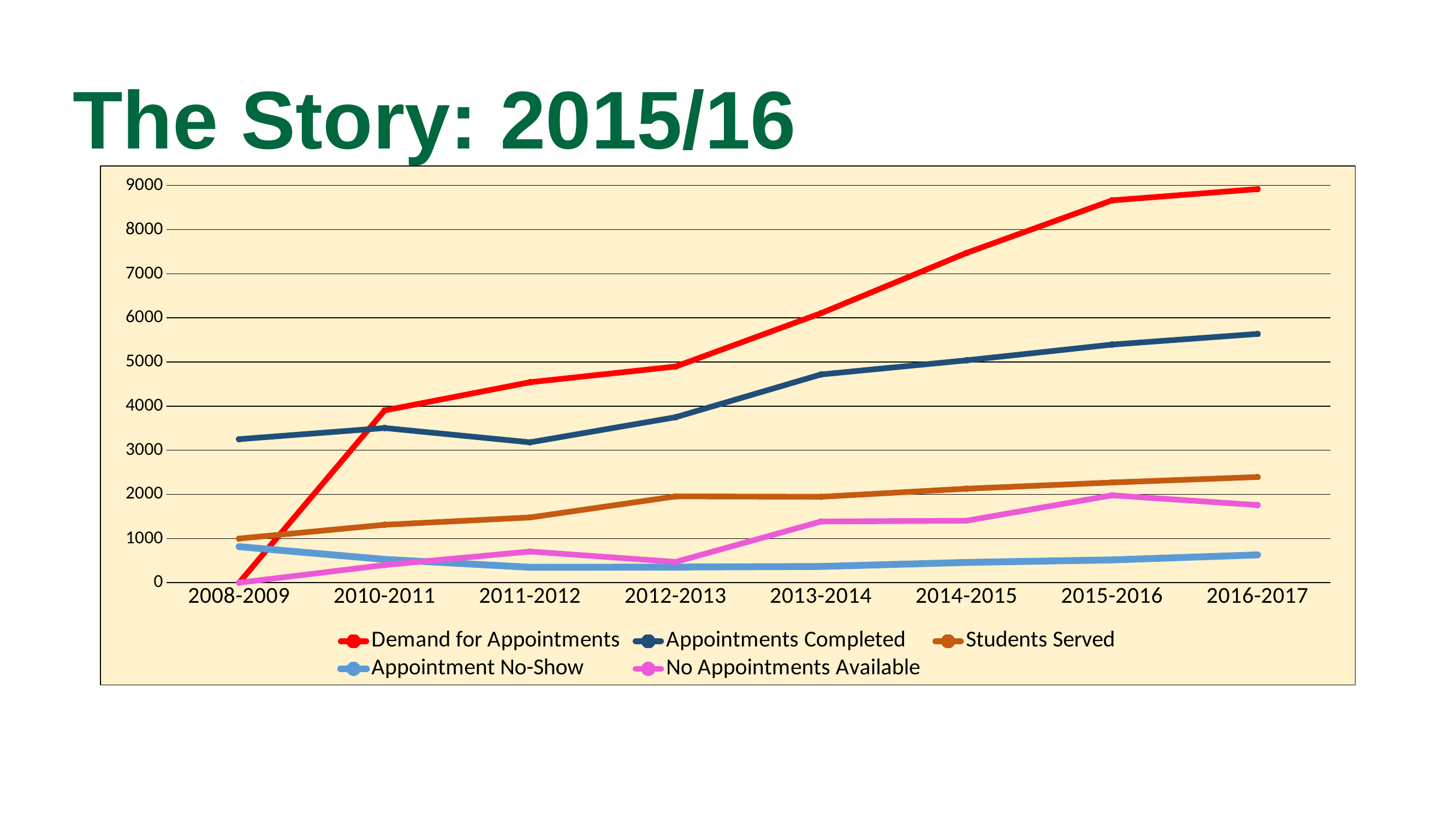
In 2008-2009, which is larger: Demand for Appointments or Appointments Completed? Appointments Completed Which series has the highest value in 2016-2017? Demand for Appointments Does the Demand for Appointments line rise or fall from 2008-2009 to 2016-2017? rise Is the value for Appointment No-Show in 2016-2017 greater or less than 1000? less What kind of chart is shown on the slide? line chart In 2016-2017, which is larger: Students Served or No Appointments Available? Students Served In which year is Demand for Appointments at its highest? 2016-2017 Is the value for Demand for Appointments in 2016-2017 greater or less than 8000? greater How many series does the legend list? 5 What colour is the Demand for Appointments line? red How many academic years are shown along the x axis? 8